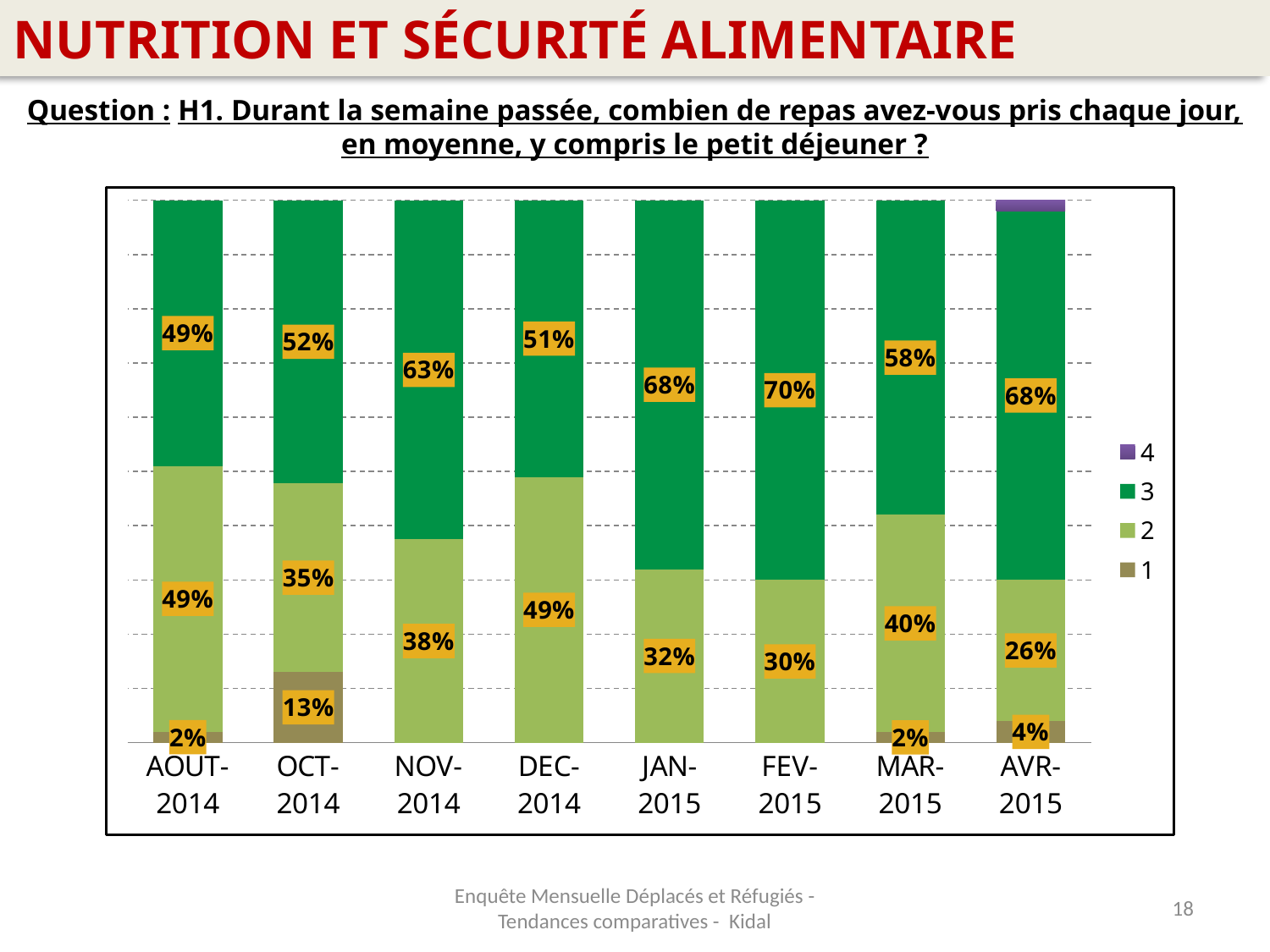
How many series does the legend list? 4 What is the value for series 2 in OCT-2014? 35% What is the value for series 3 in FEV-2015? 70% What is the value for series 1 in OCT-2014? 13% In which month is the value for series 3 highest? FEV-2015 Which legend entry is shown in purple? 4 In which month is the value for series 2 lowest? AVR-2015 Which is larger: the series 2 value for DEC-2014 or for JAN-2015? DEC-2014 What is the value for series 2 in AVR-2015? 26% What kind of chart is shown on the slide? stacked bar chart What is the difference between the series 3 values for FEV-2015 and AOUT-2014? 21% How many months are shown along the x axis? 8